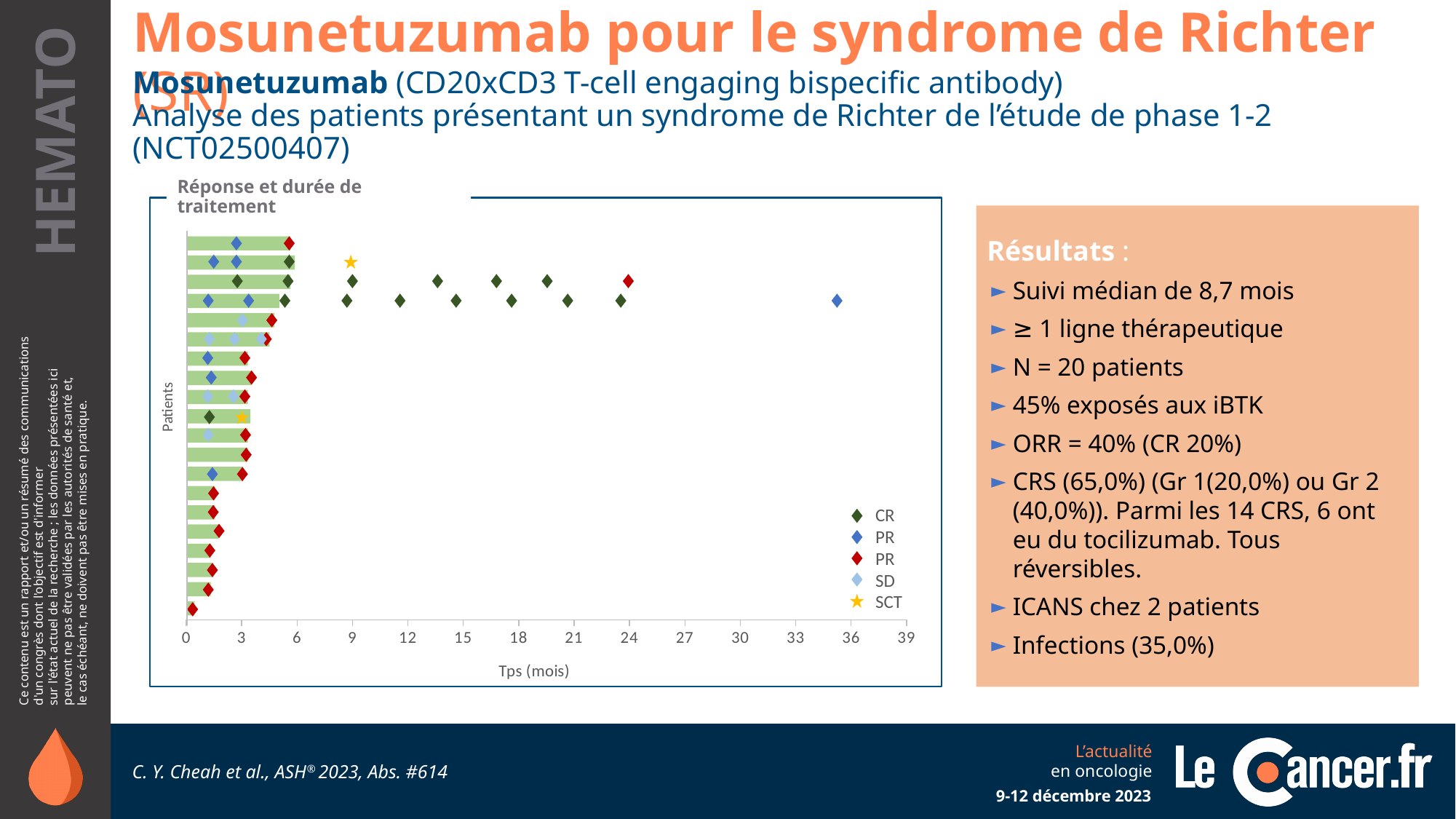
What is the highest tick value shown on the x axis of the chart? 39 What kind of chart is shown on the slide? bar chart What is the title of the chart? Réponse et durée de traitement How many patient bars are plotted in the chart? 20 Which legend entry is represented by a yellow star marker? SCT How many entries does the chart legend list? 5 Is the time value of the rightmost marker in the chart greater or less than 33 months? greater Is the length of the longest green bar in the chart greater or less than 9 months? less How many SCT star markers are plotted in the chart? 2 What is the label of the y axis of the chart? Patients What is the label of the x axis of the chart? Tps (mois)